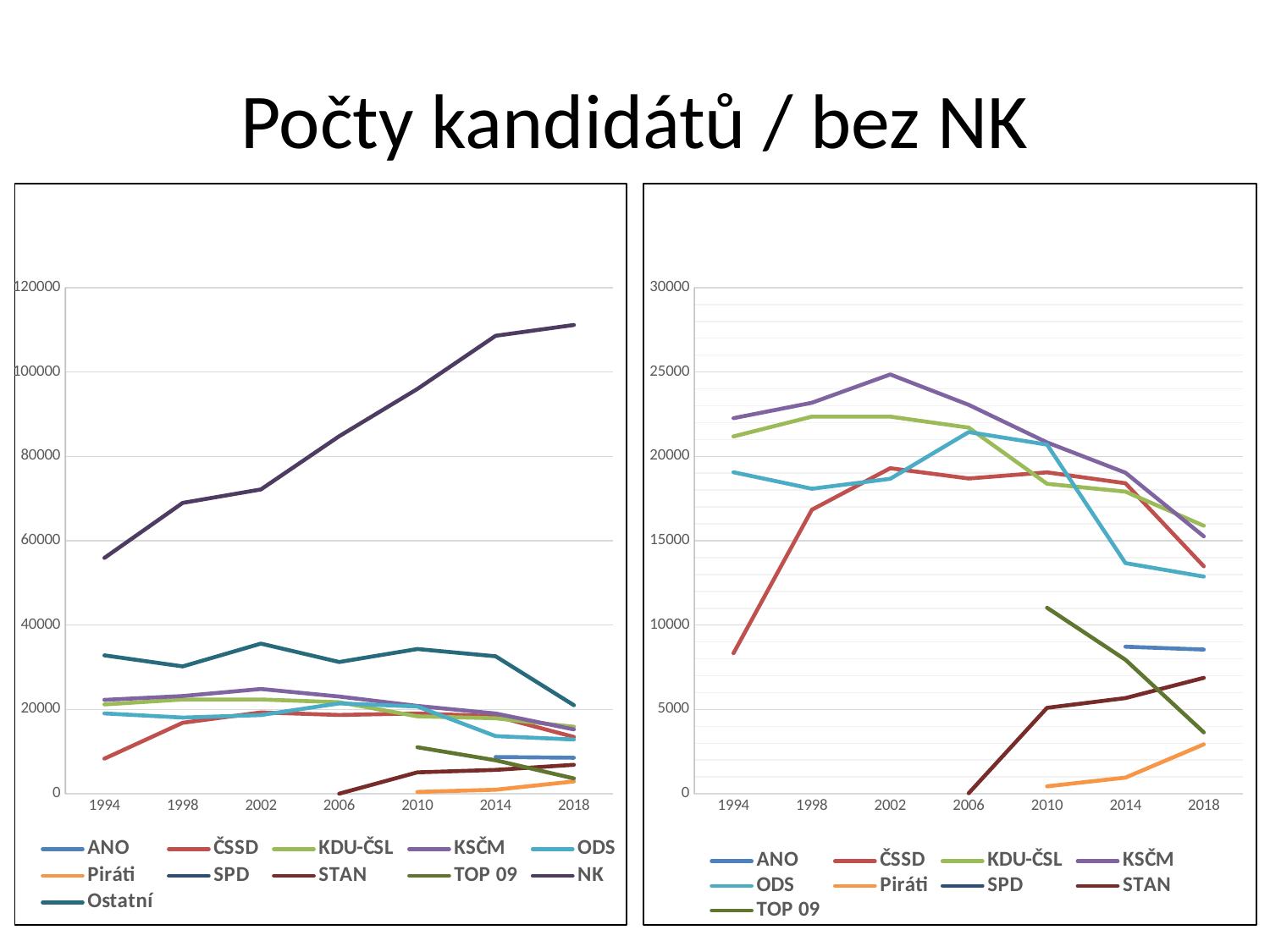
In the right chart, which series has the highest value in 2002? KSČM In the left chart, which series has the highest value in 2018? NK How many series does the legend of the left chart list? 11 In the right chart, which is larger in 2018, ANO or STAN? ANO In the left chart, does the NK series rise or fall from 1994 to 2018? rise In the right chart, does the TOP 09 series rise or fall from 2010 to 2018? fall How many series does the legend of the right chart list? 9 How many years are shown on the x axis of the right chart? 7 In the left chart, is the value for Ostatní in 2018 greater or less than 40000? less In the left chart, is the value for NK in 2018 greater or less than 100000? greater In the right chart, is the value for ČSSD in 1994 greater or less than 10000? less What kind of chart is the left chart on the slide? line chart